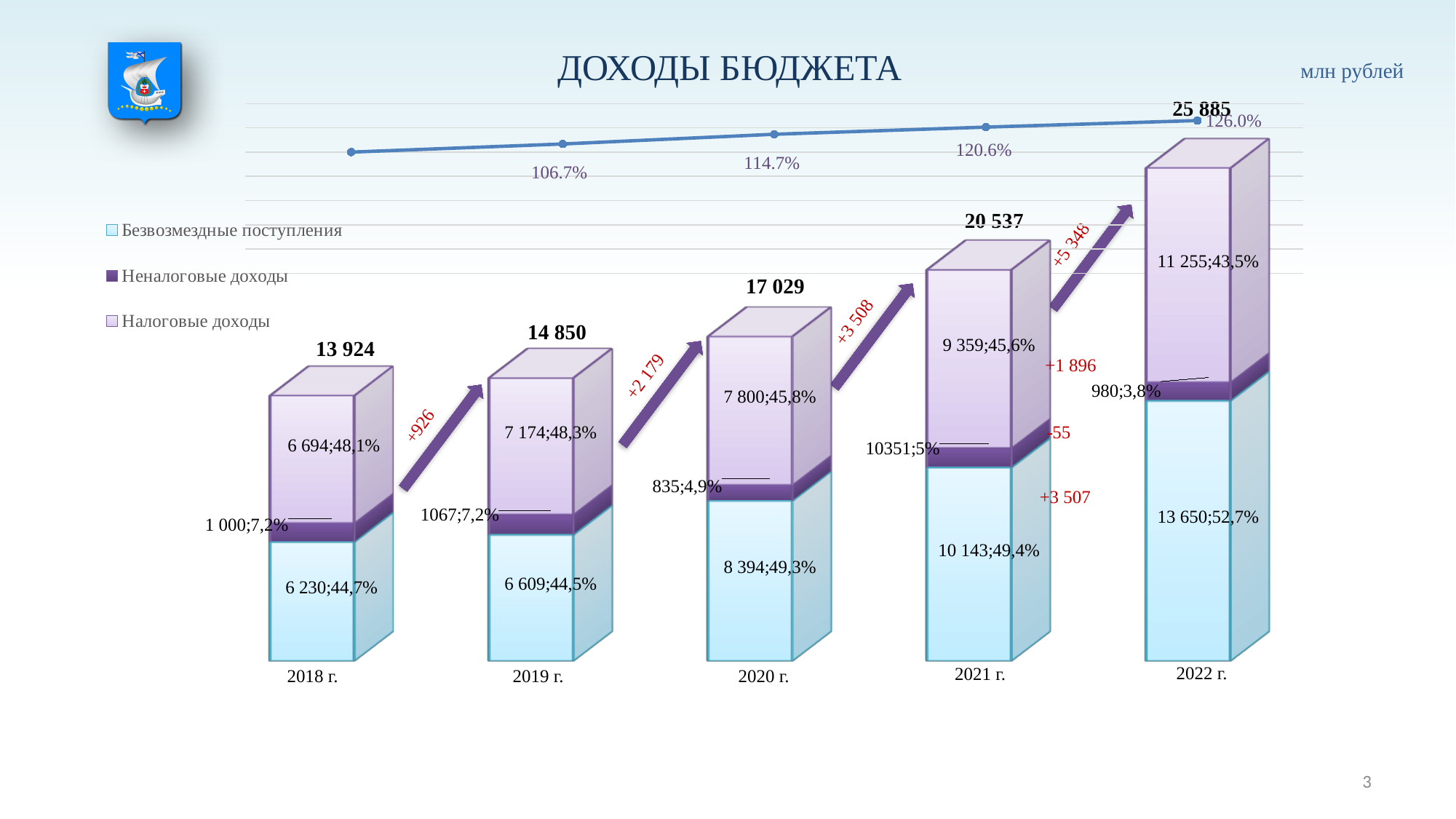
What is the difference between the total revenue for 2019 г. and 2018 г.? 926 Which year has the highest total budget revenue? 2022 г. Do the total budget revenues rise or fall from 2018 г. to 2022 г.? Rise What share of the 2022 г. total do Безвозмездные поступления make up, as labelled on the bar? 52,7% How many series does the legend list? 3 What is the total budget revenue shown above the bar for 2022 г.? 25 885 How many years are shown on the x axis? 5 Which is larger in 2020 г.: Безвозмездные поступления or Налоговые доходы? Безвозмездные поступления Which year has the lowest total budget revenue? 2018 г. What kind of chart is used to show the budget revenue by year? Stacked bar chart with a line What is the value of Налоговые доходы for 2020 г.? 7 800 What is the value of Безвозмездные поступления for 2021 г.? 10 143